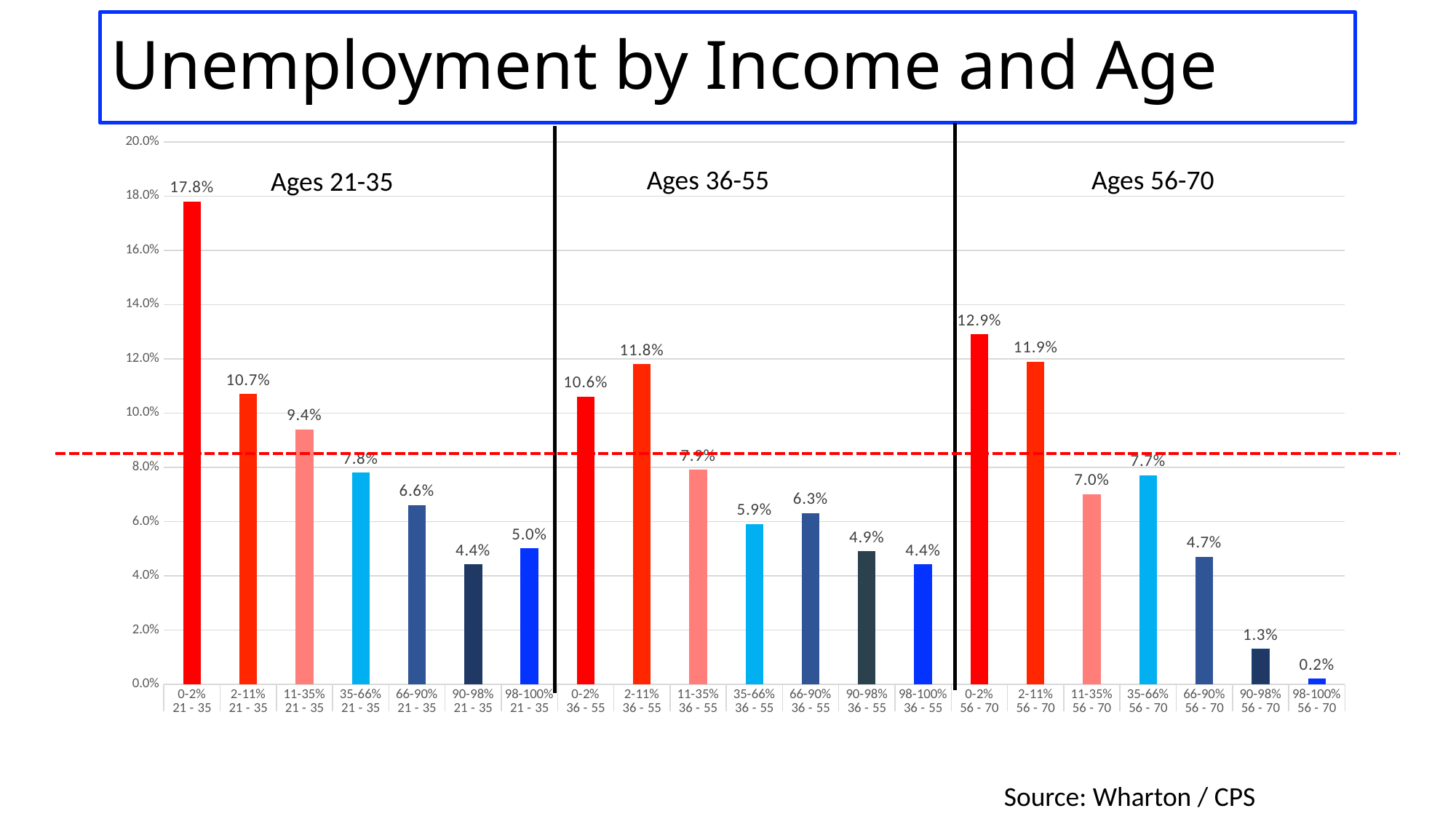
Within ages 36-55, which has the higher unemployment rate: the 0-2% income group or the 2-11% income group? 2-11% What is the unemployment rate for the 66-90% income group, ages 36-55? 6.3% What is the difference between the unemployment rate of the 0-2% income group for ages 21-35 and the 0-2% income group for ages 36-55? 7.2% What kind of chart is shown on the slide? Bar chart What is the title of the slide? Unemployment by Income and Age What is the unemployment rate for the 98-100% income group, ages 56-70? 0.2% What source is cited for the chart? Wharton / CPS Which bar has the highest unemployment rate on the chart? 0-2%, 21-35 What is the unemployment rate for the 0-2% income group, ages 21-35? 17.8% Which bar has the lowest unemployment rate on the chart? 98-100%, 56-70 What is the difference between the unemployment rates of the 0-2% and 2-11% income groups for ages 56-70? 1.0% How many bars are plotted on the chart? 21